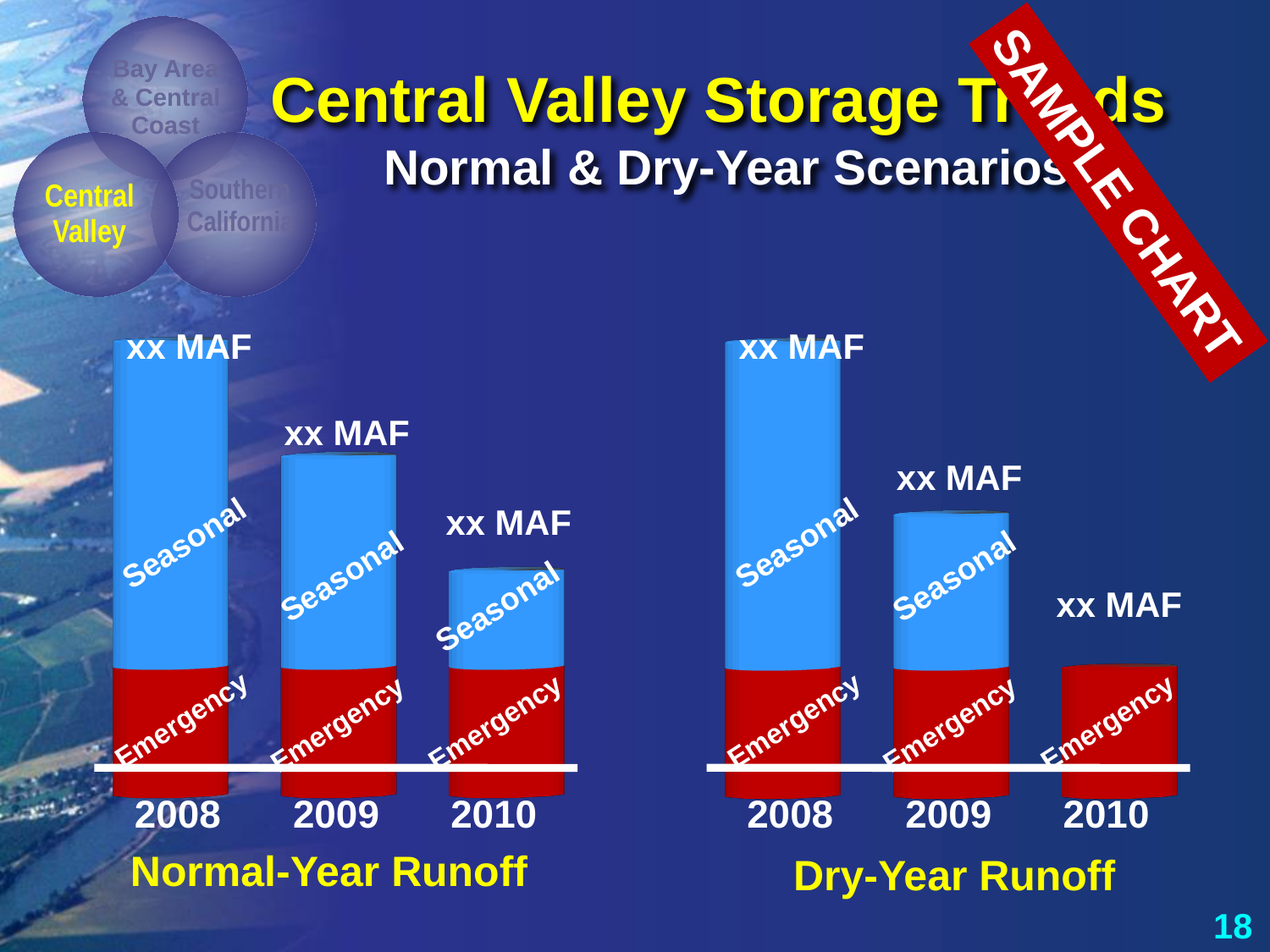
Do the bars in the Normal-Year Runoff chart rise or fall from 2008 to 2010? fall How many stacked segments (series) make up each bar in the Normal-Year Runoff chart? 2 Do the bars in the Dry-Year Runoff chart rise or fall from 2008 to 2010? fall What kind of chart is the Normal-Year Runoff chart? stacked bar chart What are the two segments labelled in each bar of the Dry-Year Runoff chart? Seasonal and Emergency In the Normal-Year Runoff chart, which year has the tallest bar? 2008 In the Dry-Year Runoff chart, which year has the shortest bar? 2010 In the Normal-Year Runoff chart, which year has the shortest bar? 2010 How many years are shown on the x axis of the Dry-Year Runoff chart? 3 In the Normal-Year Runoff chart, is the bar for 2008 or 2009 taller? 2008 In the Dry-Year Runoff chart, is the bar for 2009 or 2010 taller? 2009 In the Dry-Year Runoff chart, which year has the tallest bar? 2008